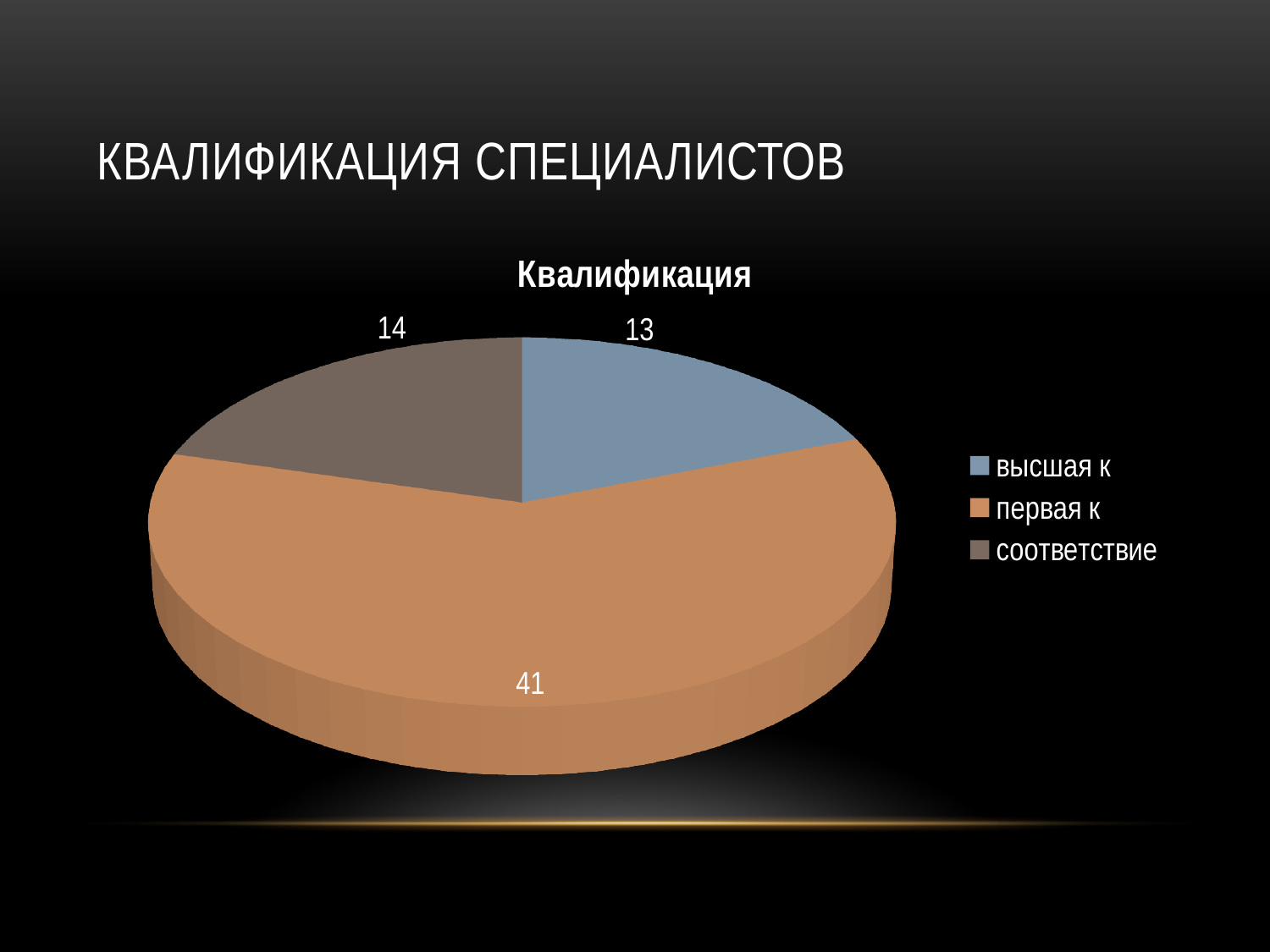
What is the value for "высшая к"? 13 How many entries does the legend list? 3 What type of chart is shown on the slide? pie chart Which category has the largest slice? первая к What is the value for "соответствие"? 14 What is the difference between the values for "первая к" and "соответствие"? 27 Which is larger, the value for "соответствие" or the value for "высшая к"? соответствие What is the title of the chart? Квалификация What is the total of all three slices in the pie chart? 68 Which category has the smallest slice? высшая к How many slices does the pie chart have? 3 What is the value for "первая к"? 41